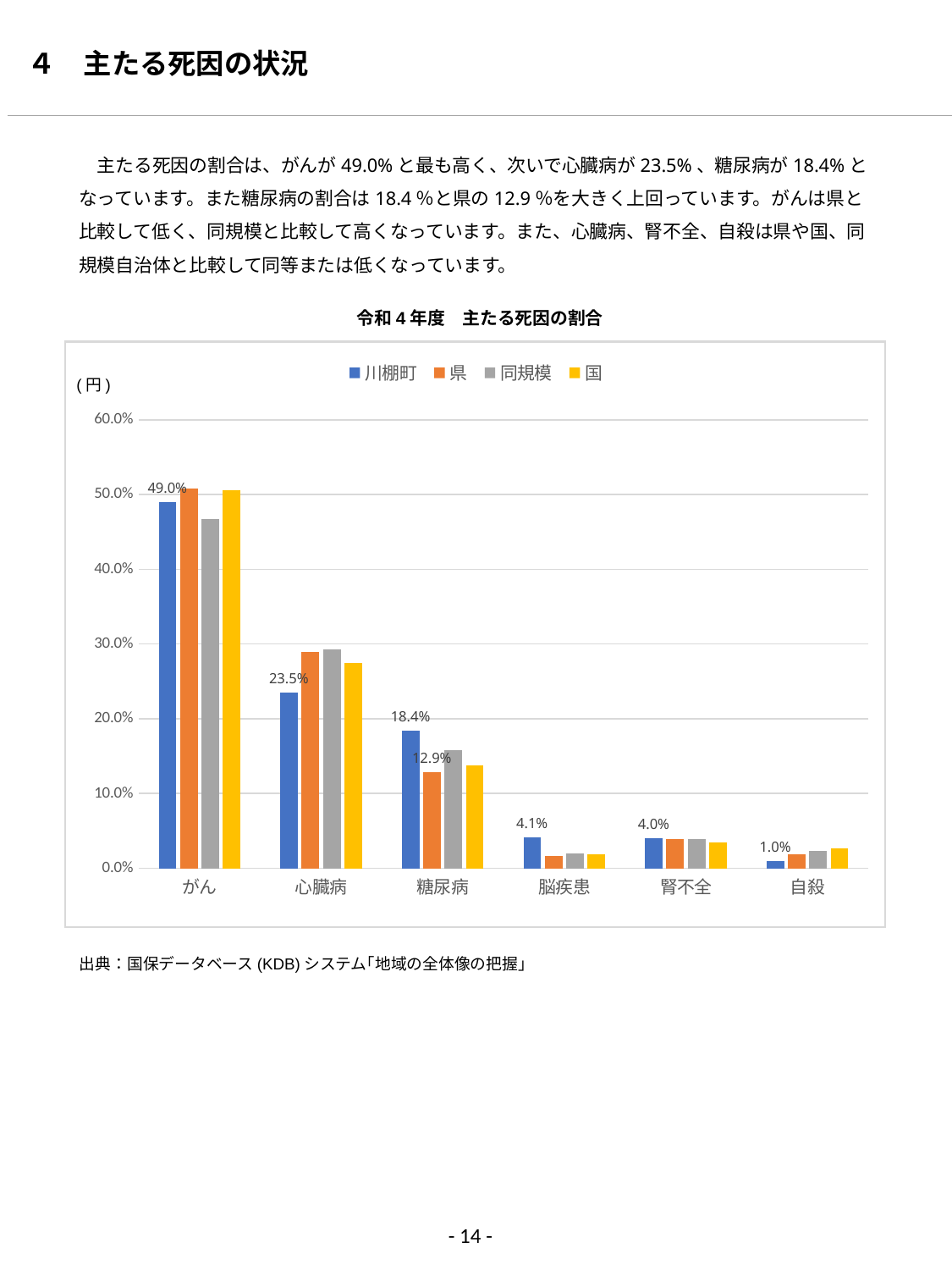
Is the value for 同規模 in the がん category greater or less than 50.0%? less How many series does the legend list? 4 What kind of chart is shown on the slide? bar chart In the 糖尿病 category, which is larger: the value for 川棚町 or the value for 県? 川棚町 How many categories are shown on the x axis? 6 What is the value for 県 in the 糖尿病 category? 12.9% What is the value for 川棚町 in the がん category? 49.0% What is the value for 川棚町 in the 心臓病 category? 23.5% What is the difference between the 川棚町 and 県 values in the 糖尿病 category? 5.5% Is the value for 国 in the 心臓病 category greater or less than 20.0%? greater Which category has the lowest value for 川棚町? 自殺 Which category has the highest value for 川棚町? がん